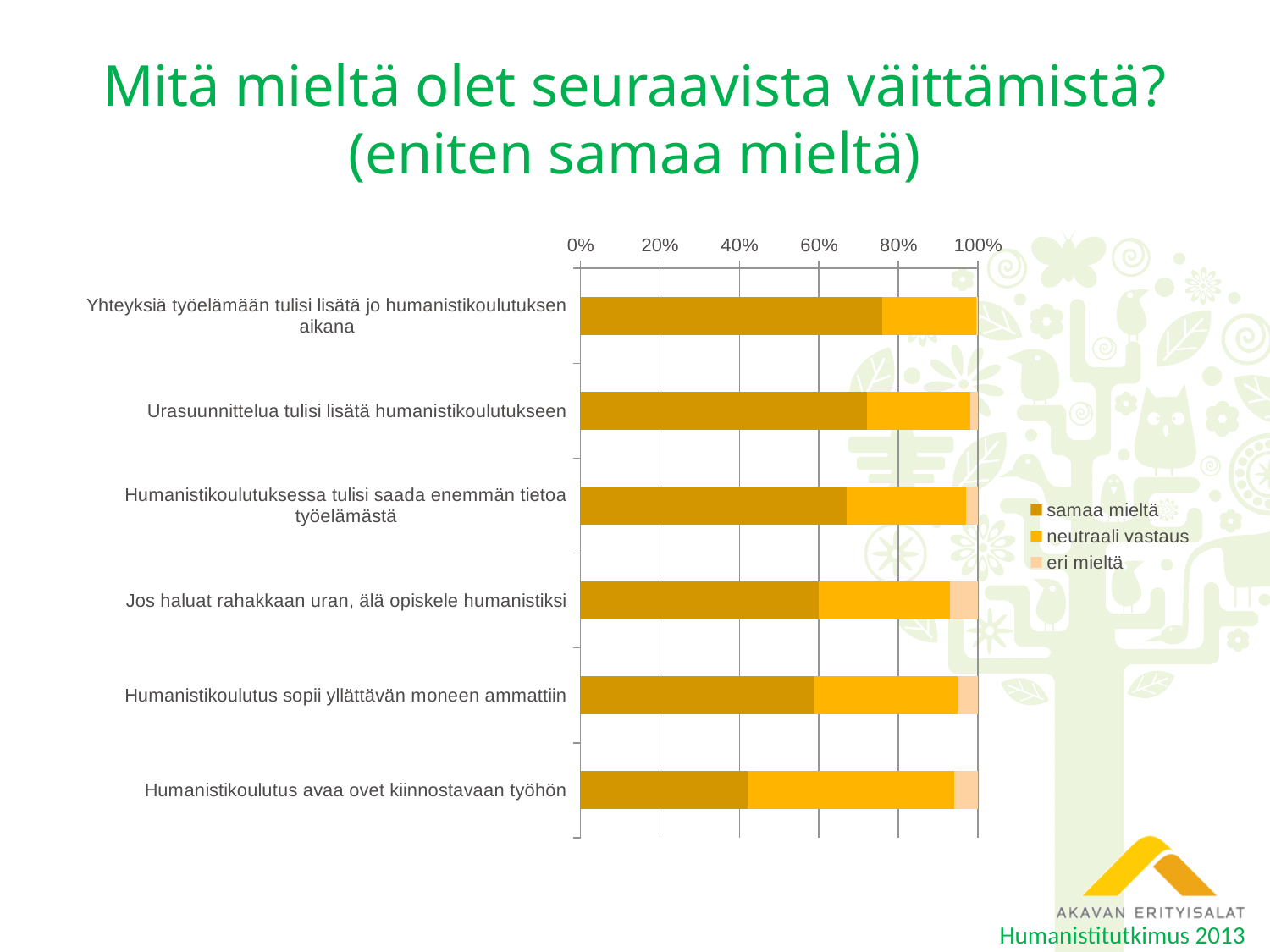
How many statements (categories) are plotted in the chart? 6 What is the title of the slide containing the chart? Mitä mieltä olet seuraavista väittämistä? (eniten samaa mieltä) What are the three series named in the legend? samaa mieltä, neutraali vastaus, eri mieltä Which statement has the lowest share of 'samaa mieltä' responses? Humanistikoulutus avaa ovet kiinnostavaan työhön Is the 'samaa mieltä' share for 'Humanistikoulutus sopii yllättävän moneen ammattiin' greater or less than 80%? less What kind of chart is shown on the slide? Stacked bar chart Which has a larger 'samaa mieltä' share: 'Urasuunnittelua tulisi lisätä humanistikoulutukseen' or 'Humanistikoulutus avaa ovet kiinnostavaan työhön'? Urasuunnittelua tulisi lisätä humanistikoulutukseen Is the 'samaa mieltä' share for 'Yhteyksiä työelämään tulisi lisätä jo humanistikoulutuksen aikana' greater or less than 60%? greater Is the 'samaa mieltä' share for 'Humanistikoulutus avaa ovet kiinnostavaan työhön' greater or less than 60%? less How many series does the legend list? 3 Which has a larger 'neutraali vastaus' share: 'Humanistikoulutus avaa ovet kiinnostavaan työhön' or 'Yhteyksiä työelämään tulisi lisätä jo humanistikoulutuksen aikana'? Humanistikoulutus avaa ovet kiinnostavaan työhön Which statement has the highest share of 'samaa mieltä' responses? Yhteyksiä työelämään tulisi lisätä jo humanistikoulutuksen aikana